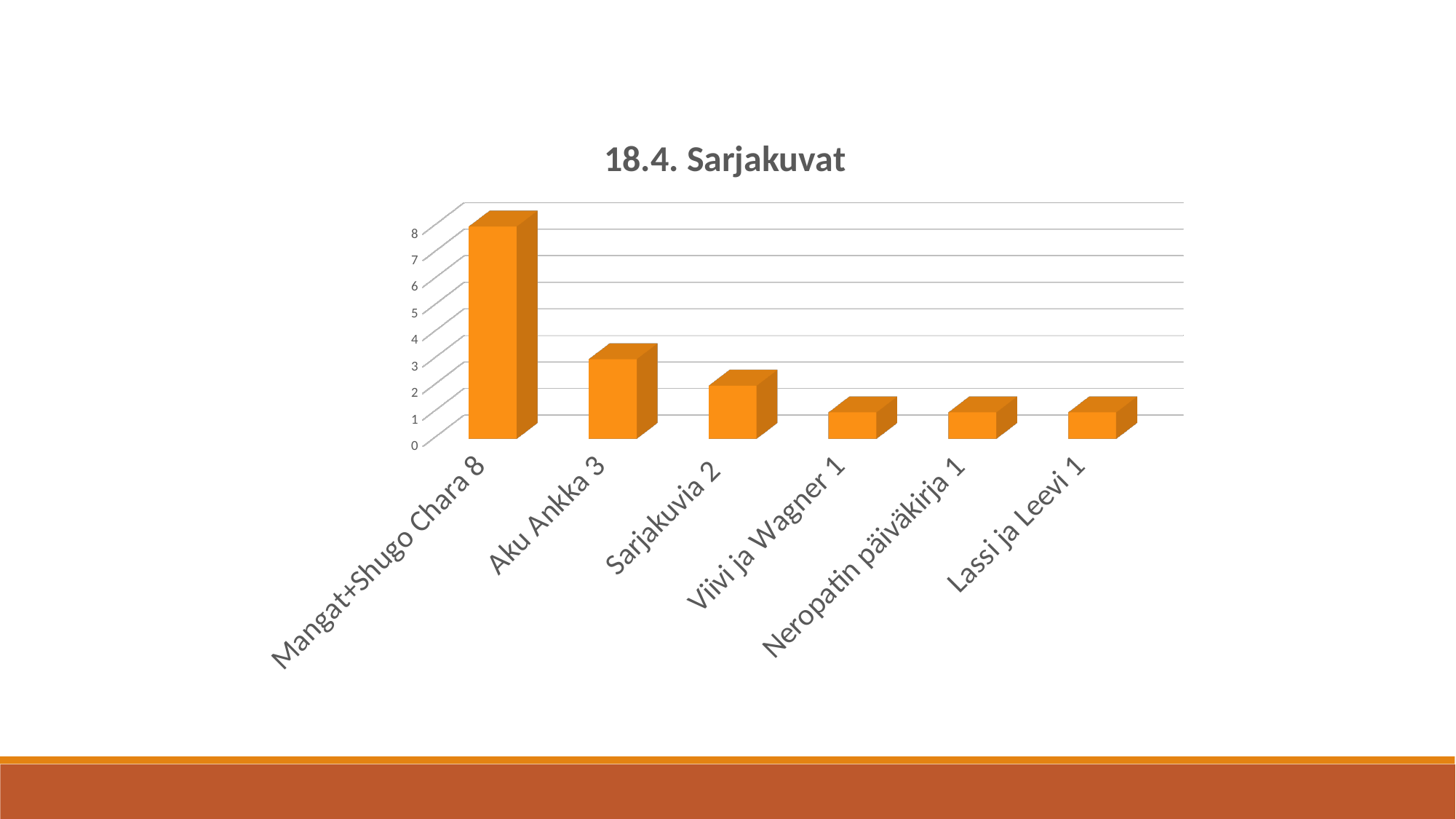
What is the value for Aku Ankka? 3 What is the title of the chart? 18.4. Sarjakuvat What is the value for Viivi ja Wagner? 1 Which category has the highest value? Mangat+Shugo Chara 8 Is the value for Mangat+Shugo Chara greater or less than 5? greater What is the difference between the values for Mangat+Shugo Chara and Aku Ankka? 5 What is the value for Mangat+Shugo Chara? 8 Which is larger, the value for Aku Ankka or the value for Sarjakuvia? Aku Ankka Do the values rise or fall from left to right along the x axis? fall What kind of chart is shown on the slide? bar chart What is the value for Sarjakuvia? 2 How many categories are plotted in the chart? 6